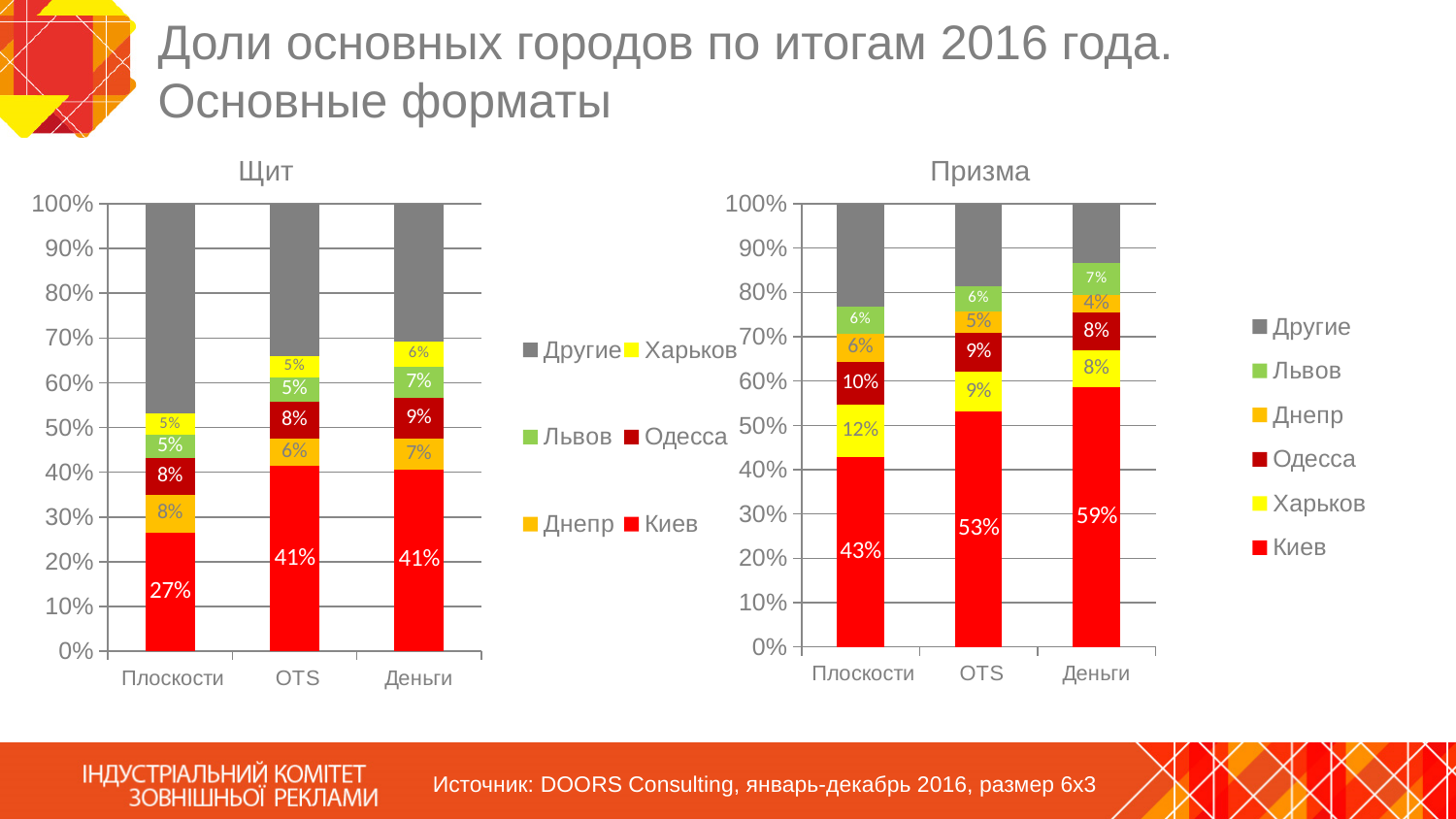
In the Призма chart, what is the value for Харьков in the Плоскости bar? 12% In the Призма chart, what is the difference between the Киев values for Деньги and Плоскости? 16% In the Призма chart, what is the value for Киев in the Деньги bar? 59% In the Щит chart, which category has the lowest value for Киев? Плоскости In the Призма chart, which category has the highest value for Киев? Деньги In the Призма chart, is the Киев value for OTS greater or less than 50%? greater How many series does the legend of the Призма chart list? 6 In the Щит chart, which is larger: the Киев value for OTS or for Плоскости? OTS In the Щит chart, what is the value for Киев in the Плоскости bar? 27% What kind of chart is the Щит chart? Stacked bar chart How many categories are shown on the x axis of the Щит chart? 3 In the Щит chart, what is the value for Одесса in the Деньги bar? 9%